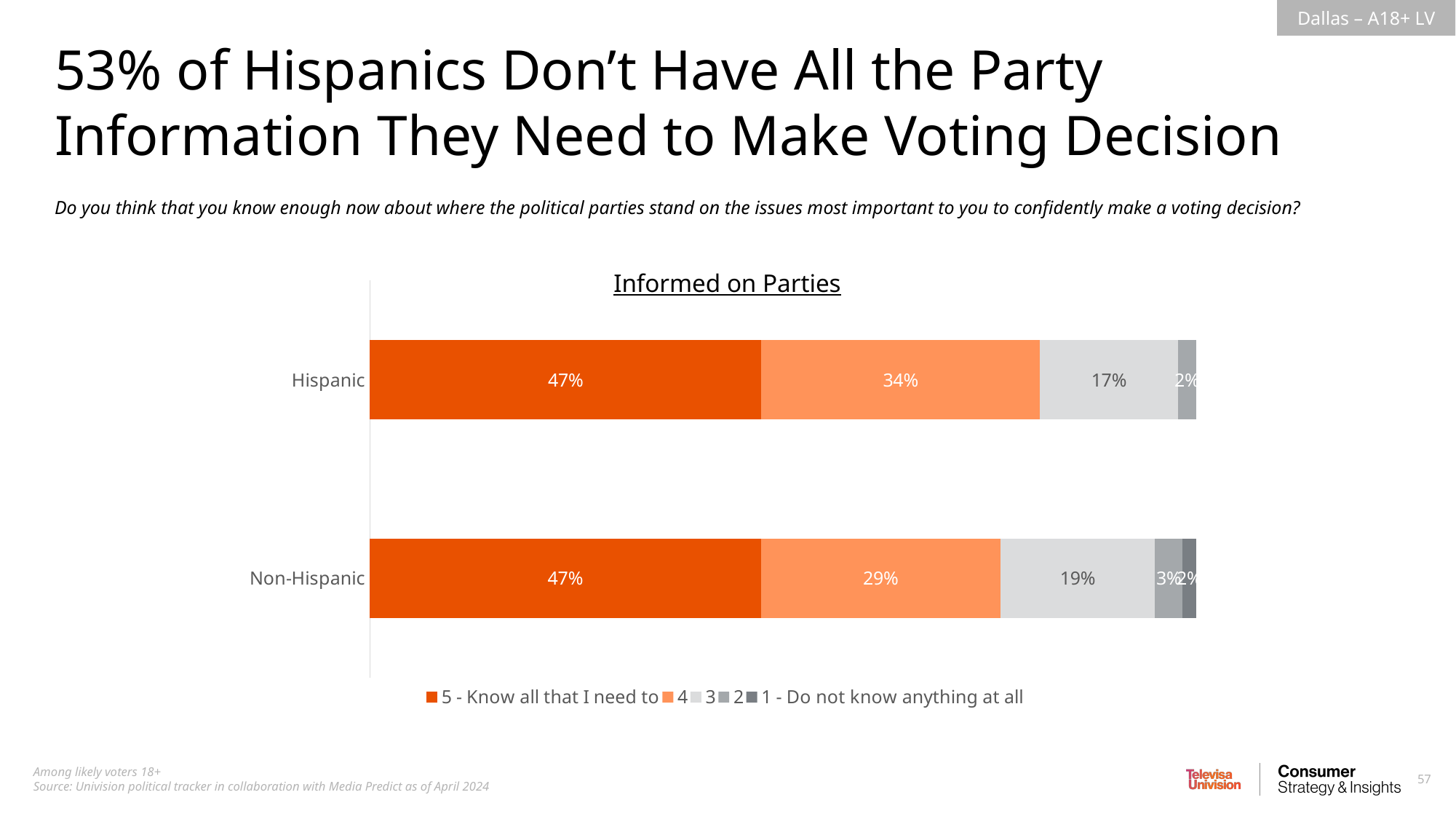
How many categories are plotted on the chart? 2 What percentage of Non-Hispanic respondents answered '3'? 19% What percentage of Non-Hispanic respondents answered '4'? 29% What is the title of the chart? Informed on Parties How many series does the chart legend list? 5 What percentage of Hispanic respondents answered '5 - Know all that I need to'? 47% Which group has the larger share answering '3', Hispanic or Non-Hispanic? Non-Hispanic What kind of chart is shown on the slide? Stacked bar chart Which legend entry is shown in the darkest orange colour? 5 - Know all that I need to What percentage of Hispanic respondents answered '3'? 17% What is the difference between the Hispanic and Non-Hispanic values for the '4' rating? 5 percentage points Which group has the larger share answering '4', Hispanic or Non-Hispanic? Hispanic